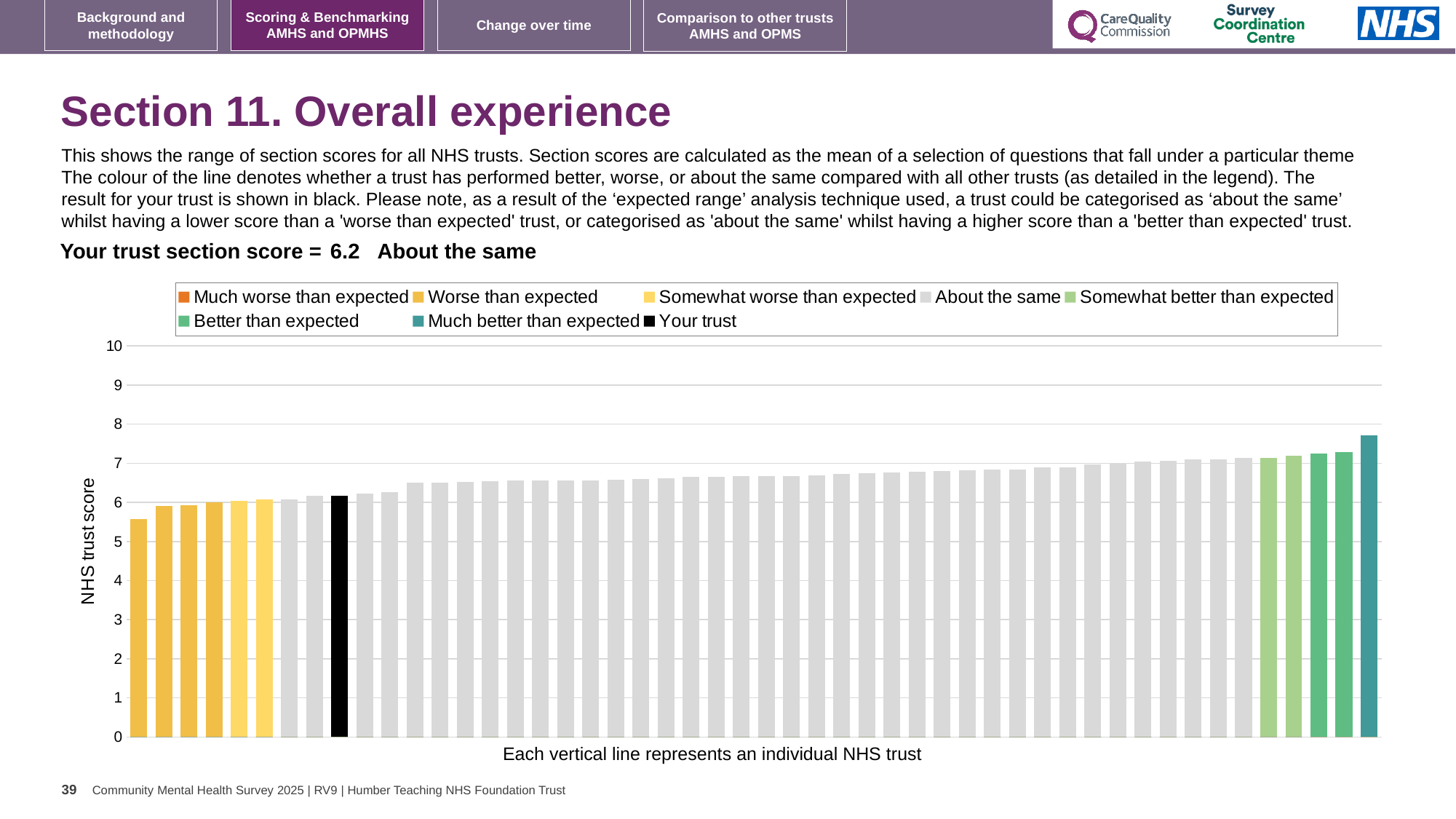
Do the bar values rise or fall from left to right along the x axis? rise What kind of chart is shown on the slide? bar chart What is the section score for your trust shown on the slide? 6.2 Which legend category does the shortest bar belong to? Worse than expected Which category is your trust placed in for this section? About the same Which legend category does the tallest bar belong to? Much better than expected How many entries does the chart legend list? 8 What colour is the bar representing your trust? black What is the label on the vertical axis of the chart? NHS trust score Is the value for your trust (the black bar) greater or less than 6? greater Is the value of the shortest bar greater or less than 6? less Is the value of the tallest bar greater or less than 7? greater